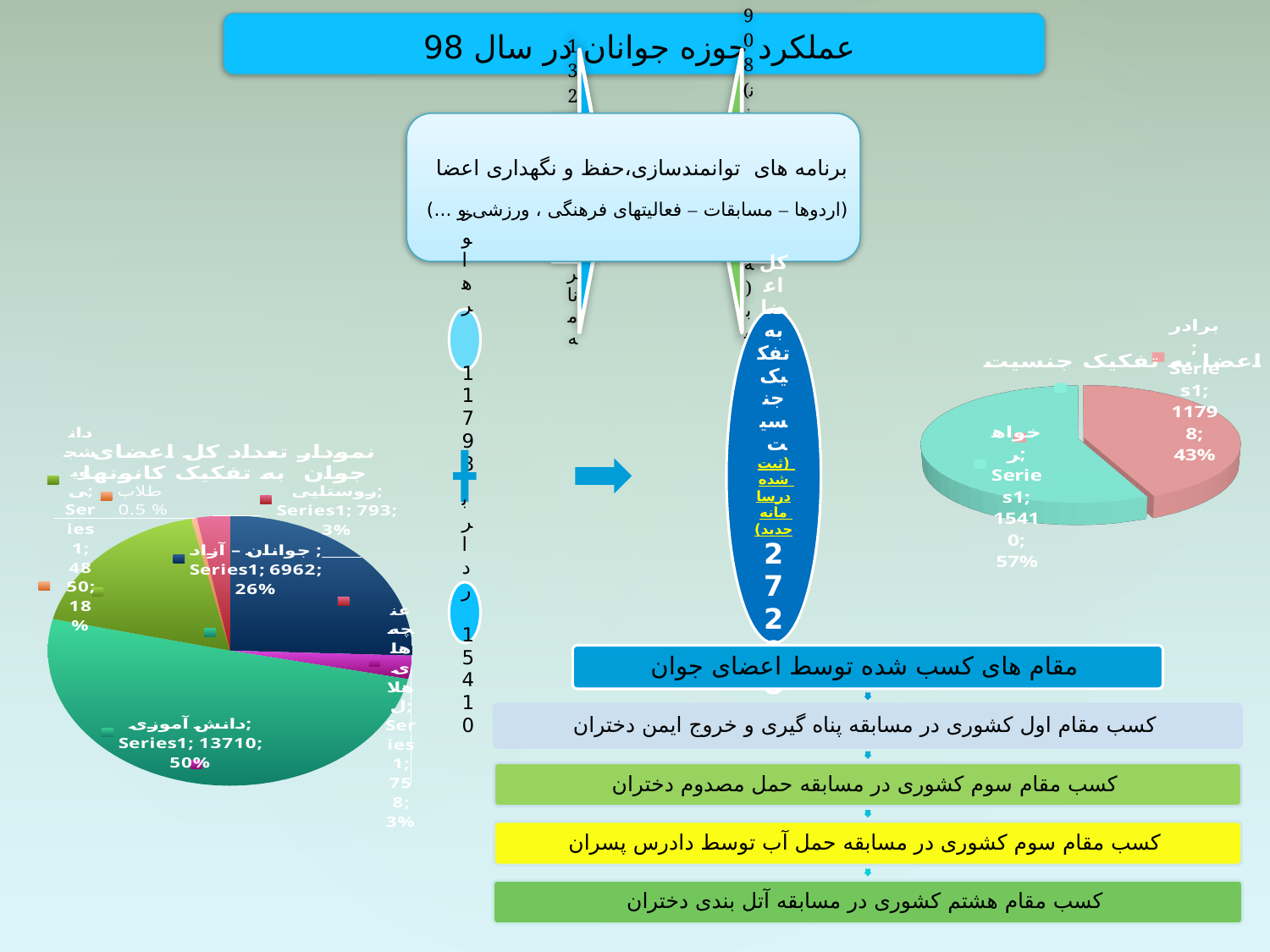
In the right pie chart (اعضا به تفکیک جنسیت), what is the difference between the values for خواهر and برادر? 3612 How many slices does the right pie chart (اعضا به تفکیک جنسیت) have? 2 In the left pie chart (تعداد کل اعضای جوان به تفکیک کانونها), what is the value for دانشجویی? 4850 In the right pie chart (اعضا به تفکیک جنسیت), what share of the pie is برادر? 43% In the left pie chart (تعداد کل اعضای جوان به تفکیک کانونها), what is the value for دانش آموزی? 13710 What kind of chart is the chart on the right of the slide (اعضا به تفکیک جنسیت)? pie chart In the left pie chart (تعداد کل اعضای جوان به تفکیک کانونها), what is the difference between the values for دانش آموزی and جوانان - آزاد? 6748 In the left pie chart (تعداد کل اعضای جوان به تفکیک کانونها), what is the value for روستایی? 793 In the right pie chart (اعضا به تفکیک جنسیت), which is larger, خواهر or برادر? خواهر In the right pie chart (اعضا به تفکیک جنسیت), what is the value for خواهر? 15410 In the left pie chart (تعداد کل اعضای جوان به تفکیک کانونها), which category has the largest slice? دانش آموزی In the left pie chart (تعداد کل اعضای جوان به تفکیک کانونها), what share of the pie is جوانان - آزاد? 26%